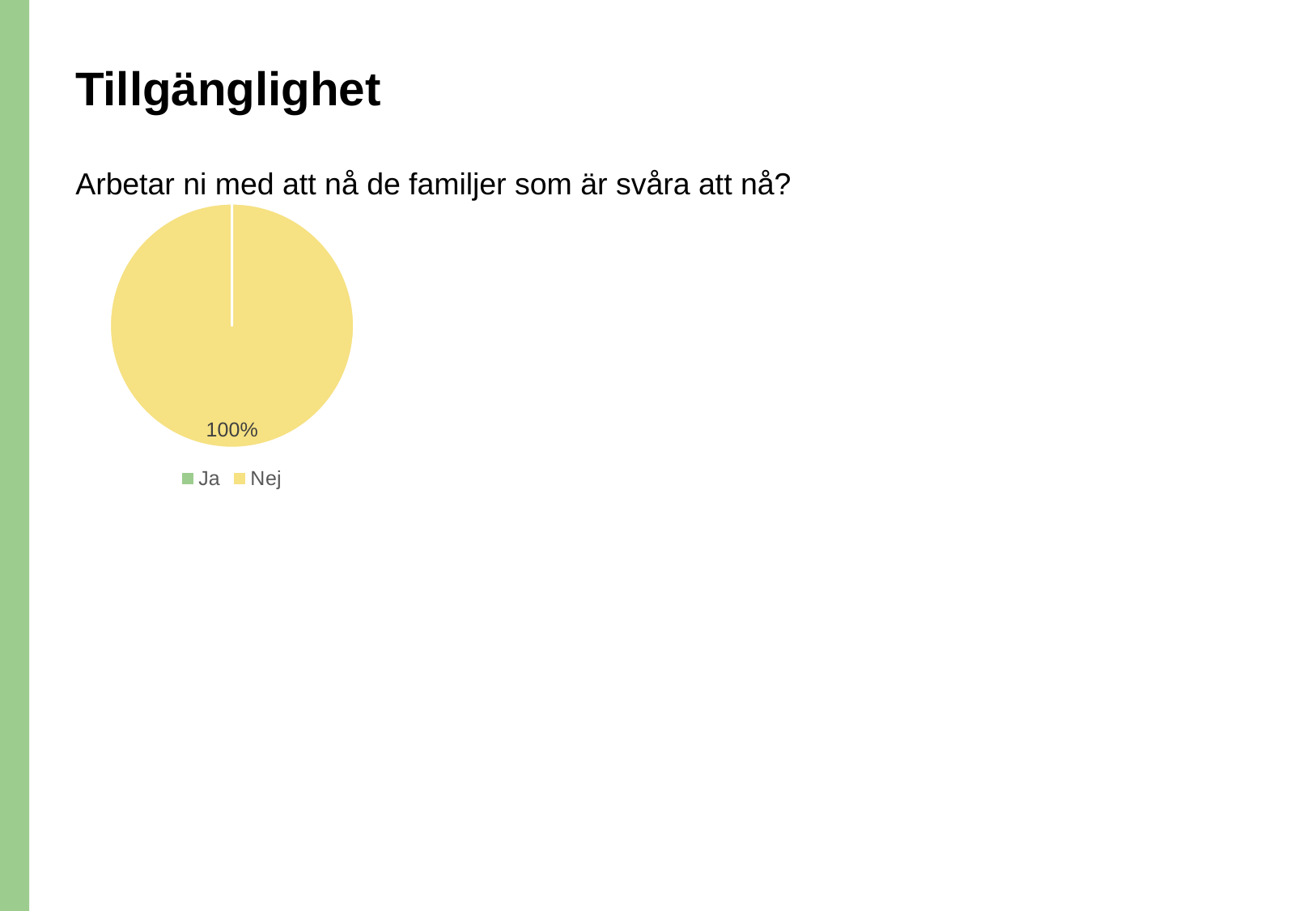
What are the two categories listed in the legend? Ja and Nej Which category has the largest share of the pie? Nej Which category has the smaller share of the pie, Ja or Nej? Ja What colour represents Nej in the pie chart? yellow What kind of chart is shown on the slide? pie chart How many categories does the legend list? 2 What share of the pie does Nej account for? 100% What is the only percentage label printed on the pie chart? 100%